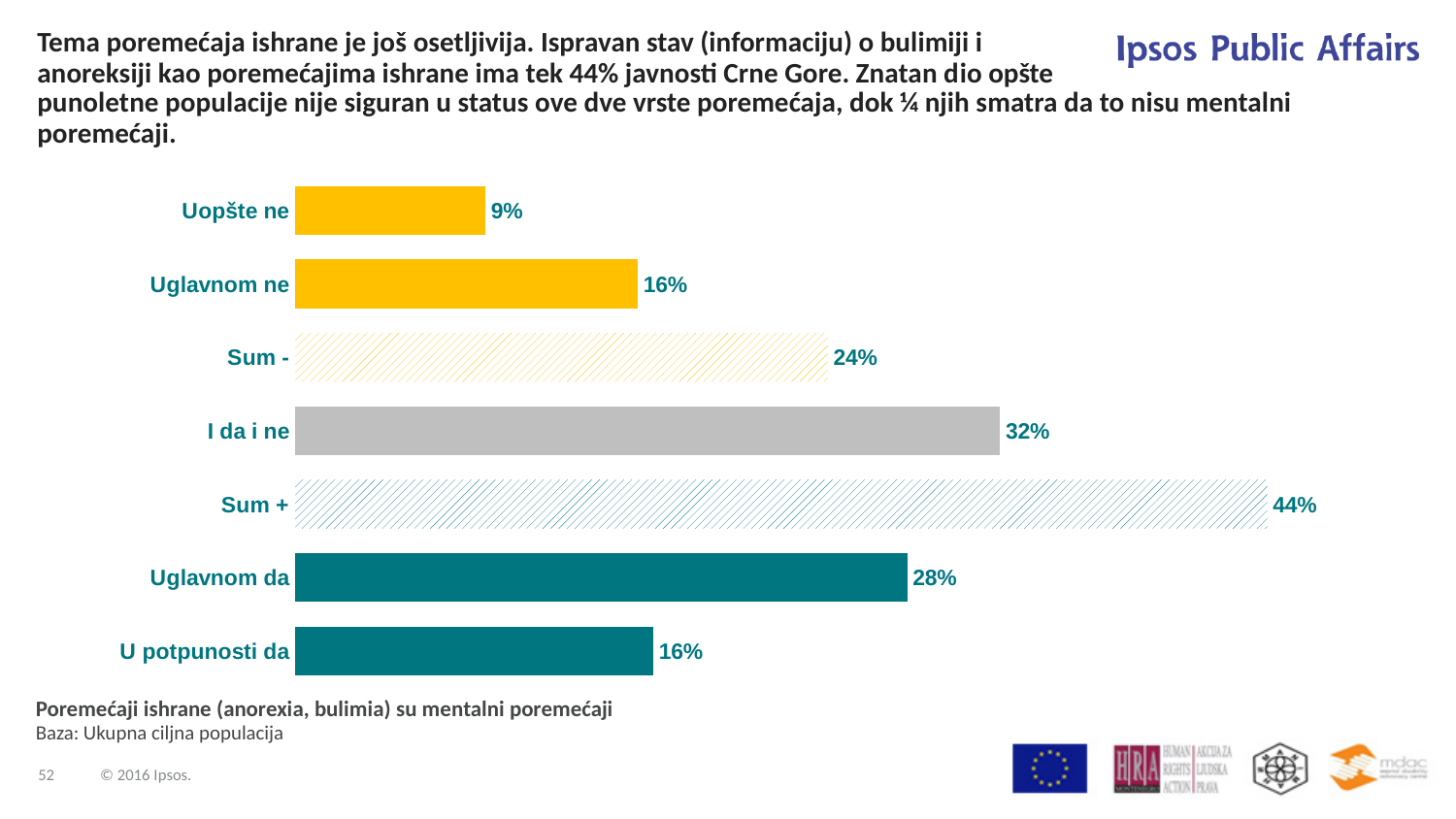
What is the value for "Uopšte ne"? 9% Which category has the highest value? Sum + What is the title text shown below the chart? Poremećaji ishrane (anorexia, bulimia) su mentalni poremećaji Which category has the lowest value? Uopšte ne What is the difference between "Uglavnom da" and "Uglavnom ne"? 12% What is the value for "I da i ne"? 32% What kind of chart is shown on the slide? Bar chart What is the difference between "Sum +" and "Sum -"? 20% Which is larger, "I da i ne" or "Uglavnom da"? I da i ne What is the value for "Sum +"? 44% What is the value for "Uglavnom da"? 28% How many bars are shown in the chart? 7